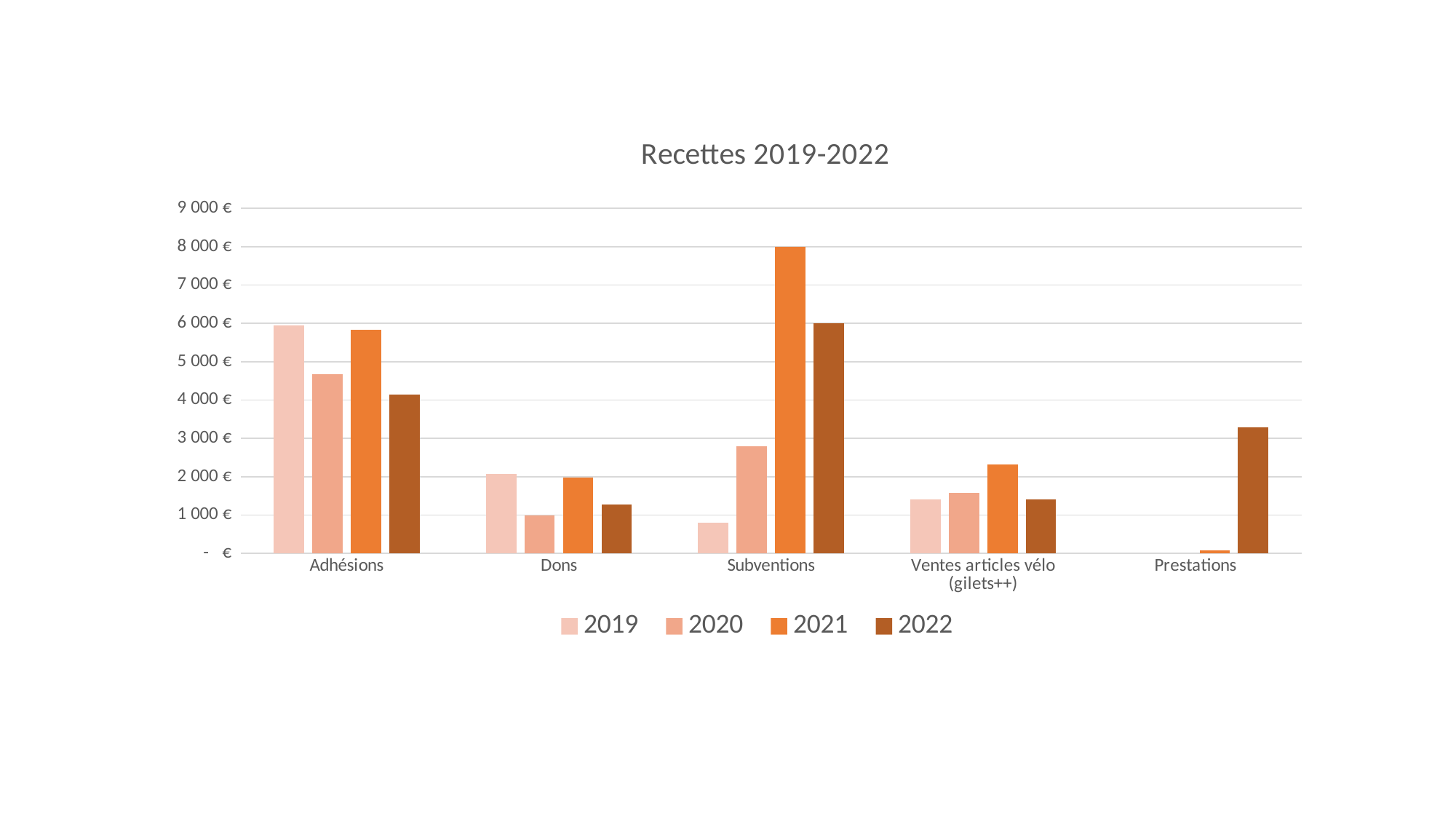
What is the difference between the Subventions values for 2021 and 2022? 2 000 € How many series does the legend list? 4 Which category has the lowest value for 2019? Subventions What is the title of the chart? Recettes 2019-2022 What is the value for Subventions in 2022? 6 000 € Which category has the highest bar for 2022? Subventions What is the value for Subventions in 2021? 8 000 € Is the value for Dons in 2020 greater or less than 2 000 €? less How many categories are shown on the x axis? 5 What kind of chart is shown on the slide? Bar chart Is the value for Adhésions in 2019 greater or less than 5 000 €? greater Which is larger for Adhésions: the 2019 value or the 2020 value? 2019